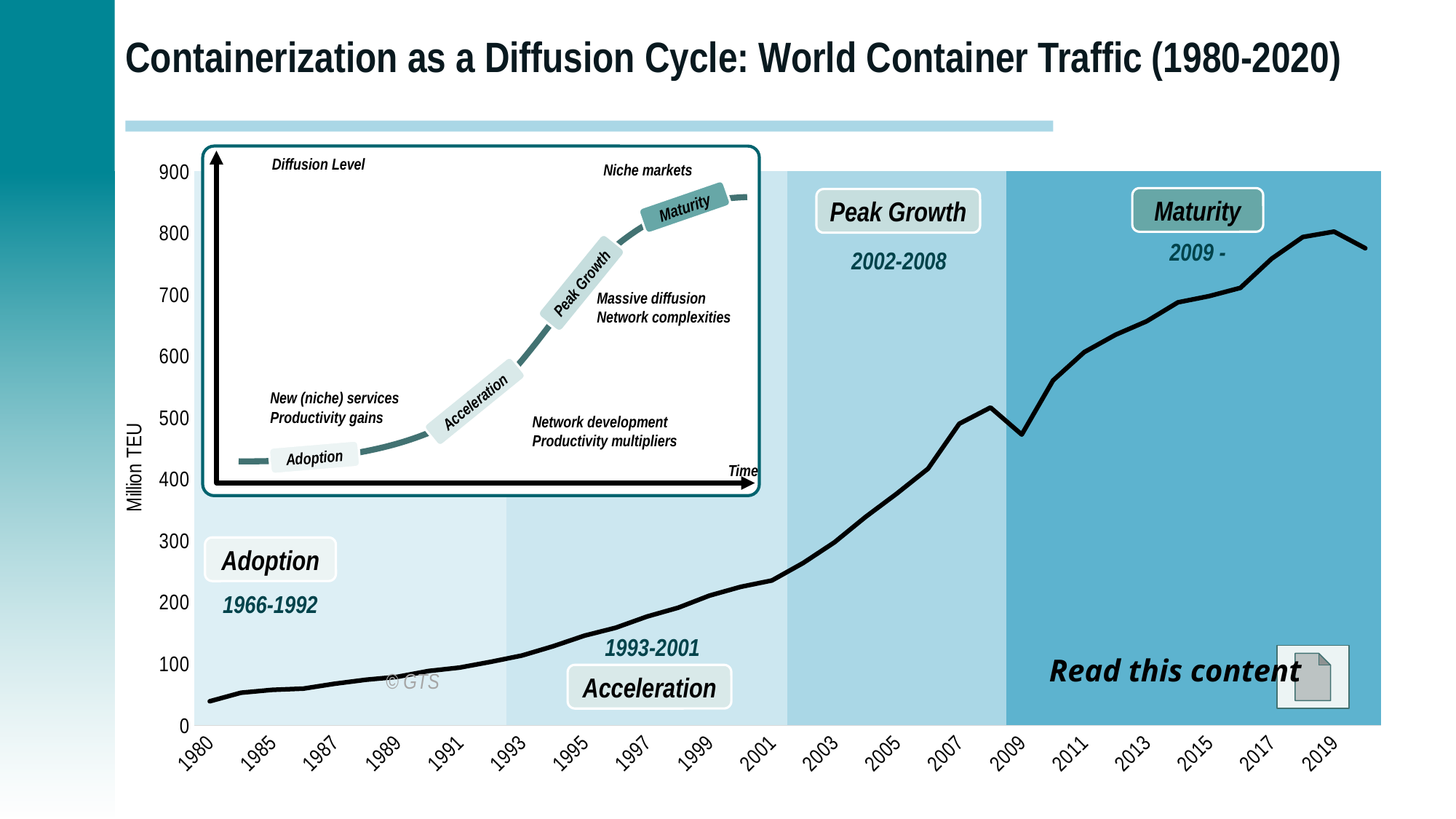
Which years does the Peak Growth phase cover according to the main chart? 2002-2008 Which year has higher container traffic on the main chart, 2001 or 2011? 2011 Is the container traffic value for 2013 greater or less than 600 Million TEU? greater Overall, does world container traffic rise or fall from 1980 to 2019 on the main chart? rise What is the label on the vertical axis of the main chart? Million TEU Is the container traffic value for 1993 greater or less than 200 Million TEU? less Is the container traffic value for 2017 greater or less than 700 Million TEU? greater How many diffusion phases are marked as shaded bands on the main chart? 4 What kind of chart is used to show world container traffic on the slide? line chart Which year has the lowest container traffic on the main chart? 1980